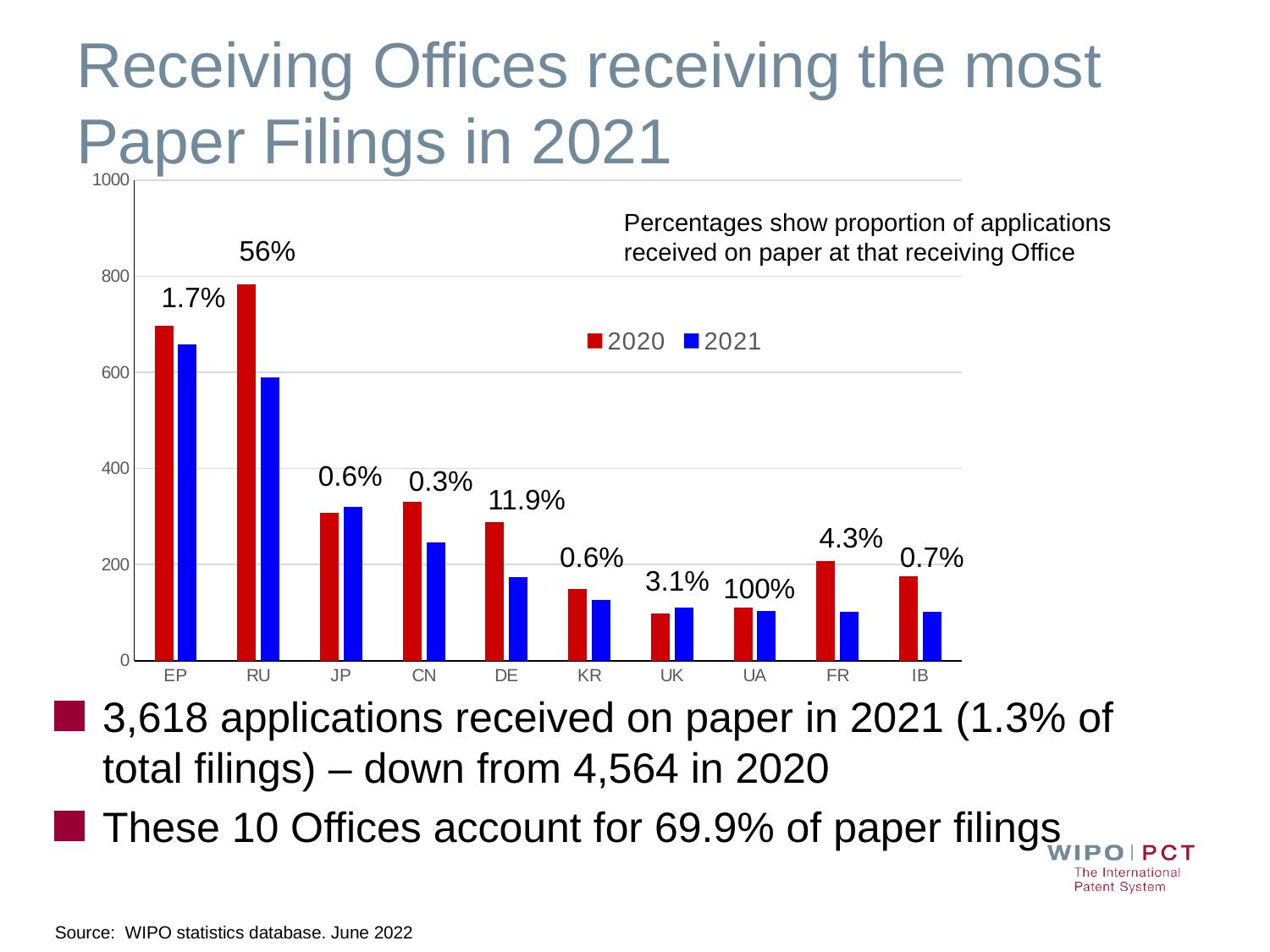
What percentage label is shown above the bars for EP? 1.7% How many series does the chart's legend list? 2 How many receiving Offices are shown on the x axis of the chart? 10 Which receiving Office has the highest 2020 bar in the chart? RU What percentage label is shown above the bars for UA? 100% Is the 2020 value for EP greater or less than 600? greater What kind of chart is shown on the slide? bar chart Is the 2021 value for DE greater or less than 200? less For CN, which is larger: the 2020 bar or the 2021 bar? 2020 What percentage of applications were received on paper at RU according to the chart label? 56% Which colour represents the 2021 series in the chart? blue What percentage label is shown above the bars for DE? 11.9%